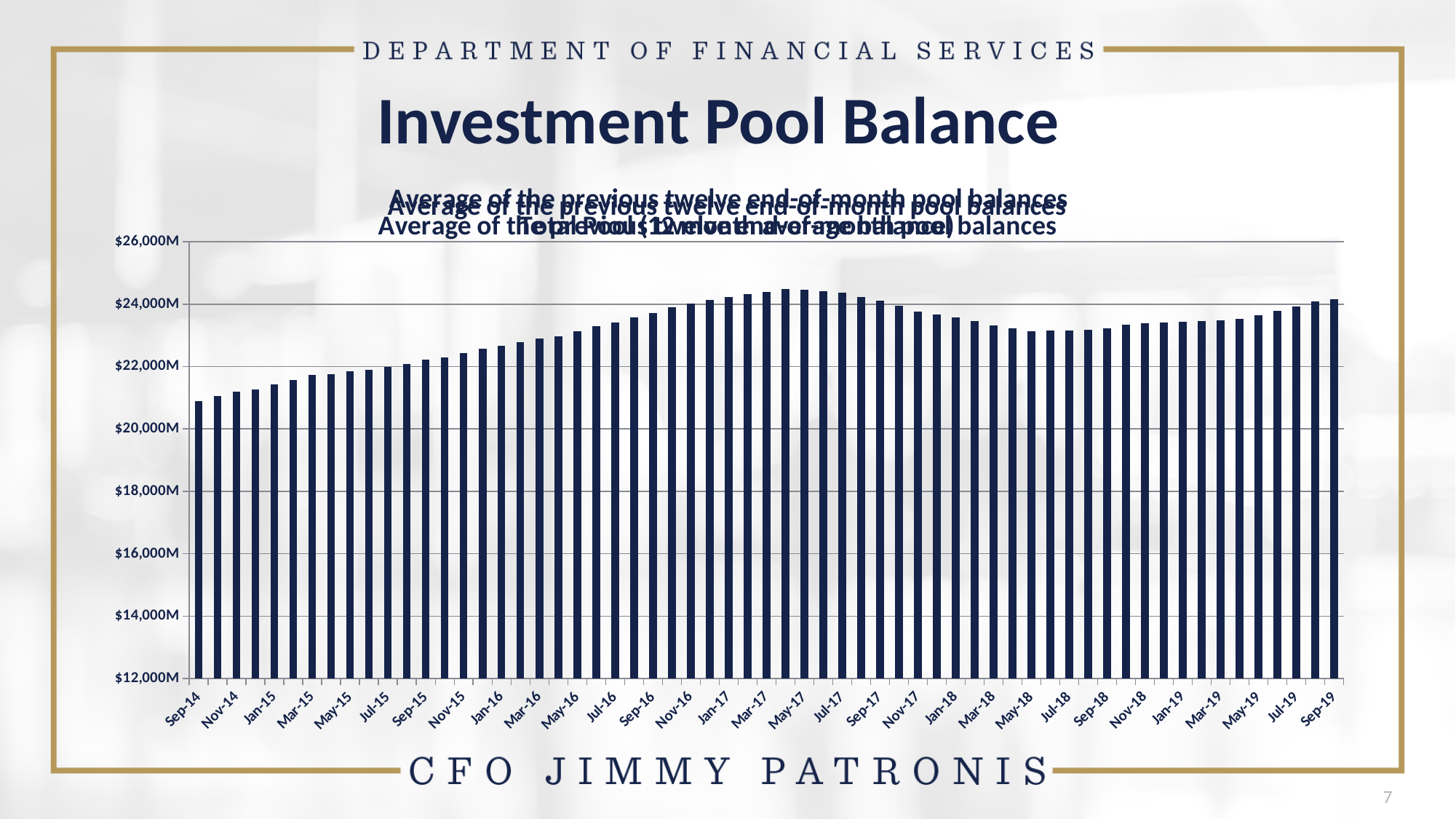
What is the first month shown on the horizontal axis? Sep-14 What is the highest value shown on the vertical axis? $26,000M Is the value for Jul-18 greater or less than $24,000M? less Which is larger, the value for Sep-14 or the value for Sep-19? Sep-19 Which is larger, the value for May-17 or the value for Jul-18? May-17 Is the value for May-17 greater or less than $24,000M? greater Do the values generally rise or fall from Sep-14 to May-17? rise What kind of chart is shown on the slide? Bar chart Is the value for Sep-19 greater or less than $22,000M? greater Which month has the lowest investment pool balance on the chart? Sep-14